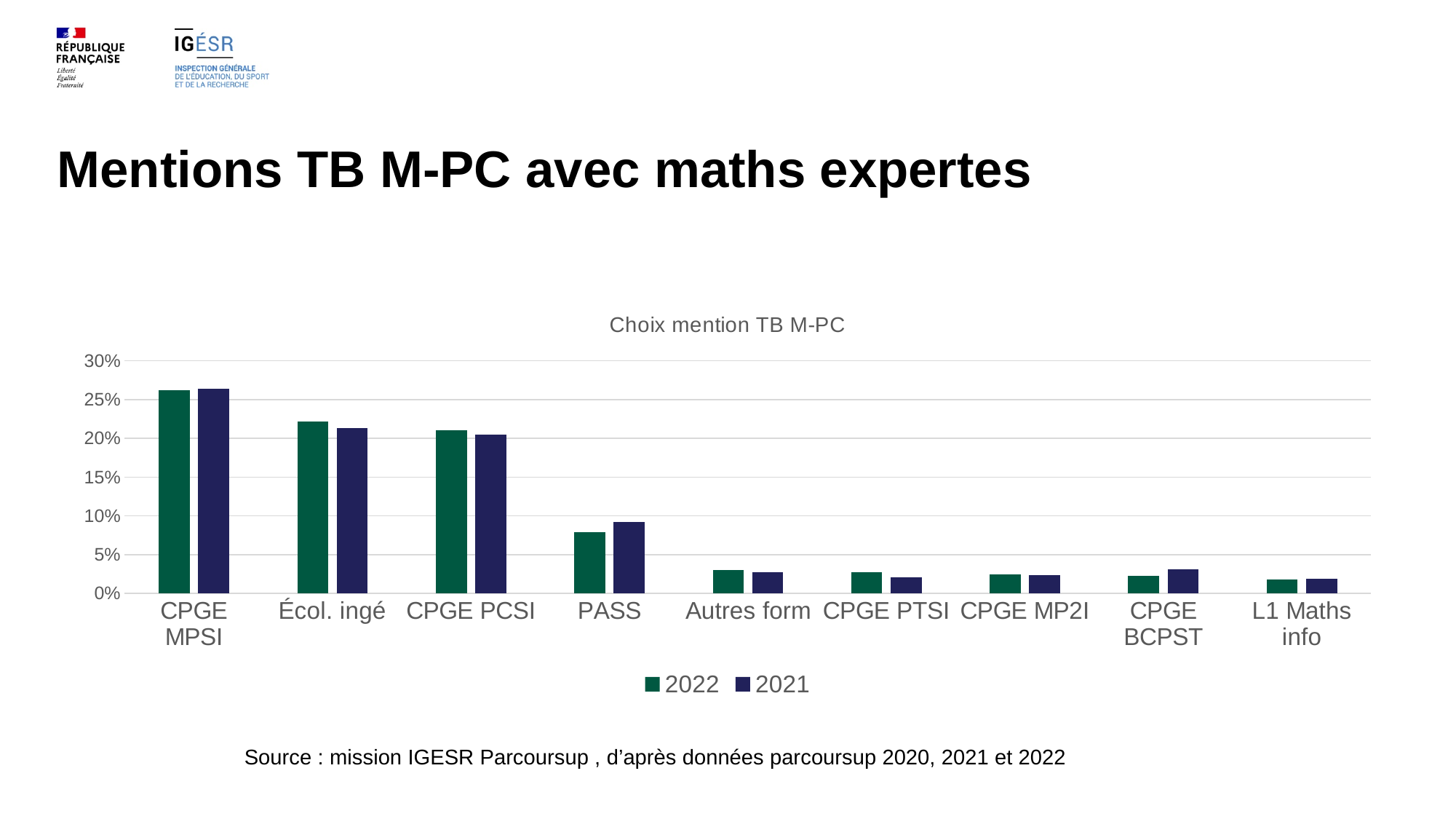
How many categories are shown on the x axis of the chart? 9 Which category has the lowest value for 2022? L1 Maths info Do the 2022 values generally rise or fall from left to right along the x axis? fall Which category has the highest value for 2021? CPGE MPSI What kind of chart is shown on the slide? bar chart How many series does the chart's legend list? 2 For Écol. ingé, which series has the larger value, 2022 or 2021? 2022 Is the 2021 value for PASS greater or less than 10%? less Is the 2022 value for CPGE MPSI greater or less than 25%? greater Is the 2022 value for Autres form greater or less than 5%? less Which category has the highest value for 2022? CPGE MPSI For PASS, which series has the larger value, 2022 or 2021? 2021